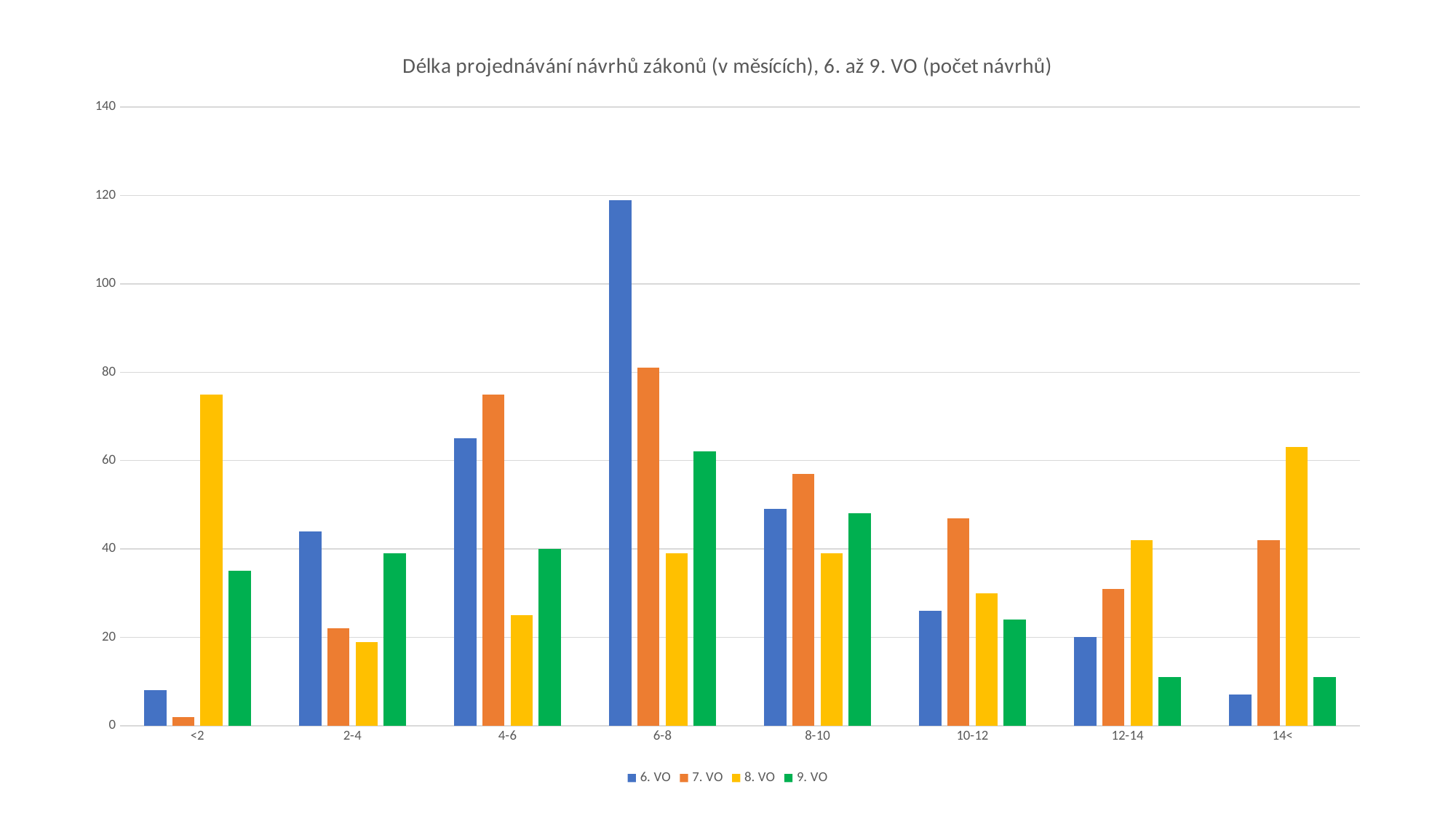
How many categories are shown on the x axis? 8 How many series does the legend list? 4 In which category is the value for 8. VO highest? <2 In the 4-6 category, which is larger: the value for 6. VO or for 7. VO? 7. VO Is the value for 6. VO in the 12-14 category greater or less than 40? less In which category is the value for 9. VO highest? 6-8 What kind of chart is shown on the slide? bar chart What is the title of the chart? Délka projednávání návrhů zákonů (v měsících), 6. až 9. VO (počet návrhů) Is the value for 7. VO in the <2 category greater or less than 20? less In which category is the value for 7. VO lowest? <2 Is the value for 6. VO in the 6-8 category greater or less than 100? greater In which category is the value for 6. VO highest? 6-8